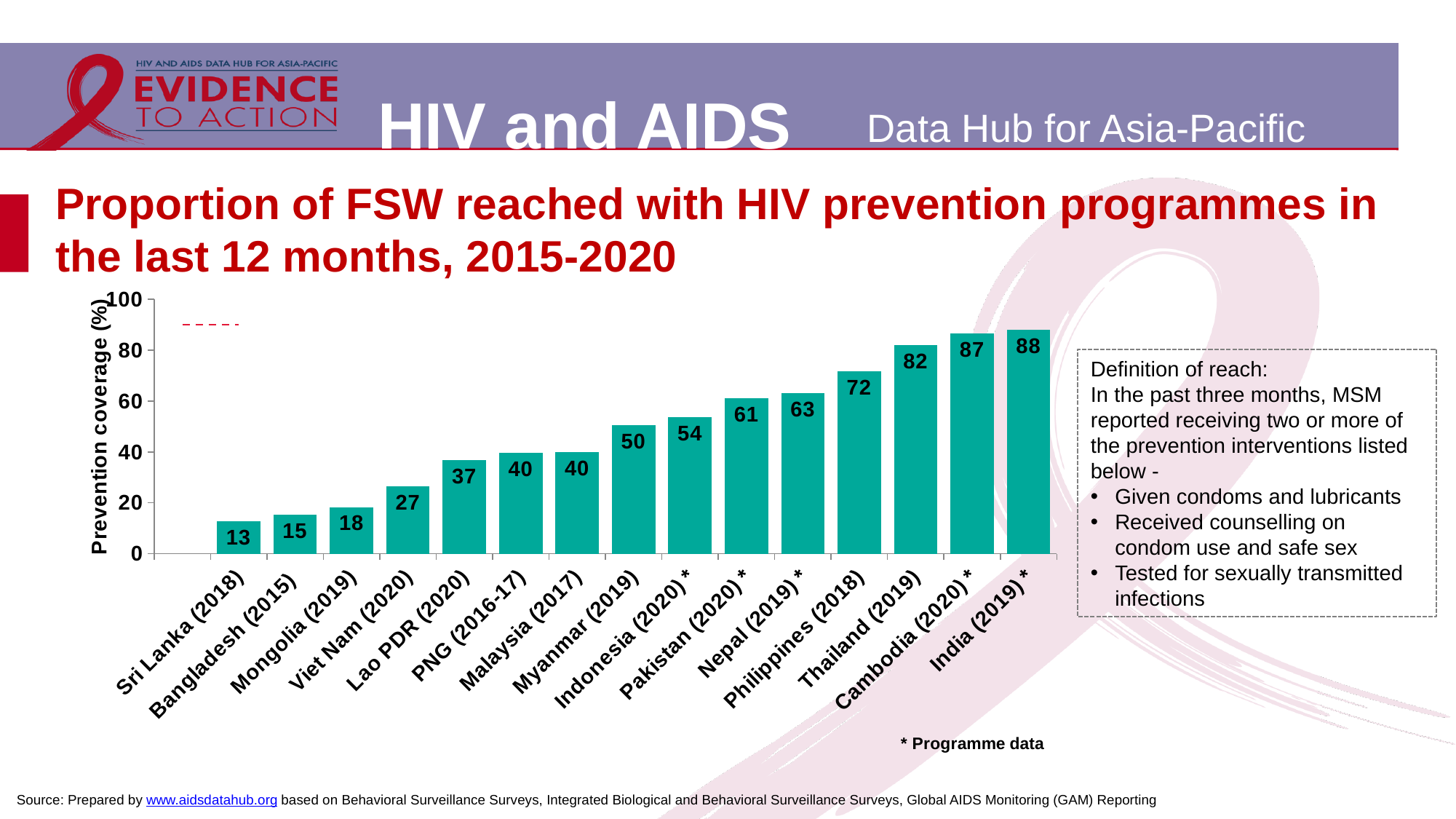
What is the label of the y axis? Prevention coverage (%) Is the value for Philippines (2018) greater or less than 60? greater Do the values rise or fall from left to right along the x axis? Rise Which country has the highest prevention coverage? India (2019)* What type of chart is shown on the slide? Bar chart What is the prevention coverage value for Viet Nam (2020)? 27 Which has a higher prevention coverage, Nepal (2019)* or Lao PDR (2020)? Nepal (2019)* Which country has the lowest prevention coverage? Sri Lanka (2018) How many countries are shown on the chart? 15 What is the difference in prevention coverage between Cambodia (2020)* and Mongolia (2019)? 69 What is the prevention coverage value for Pakistan (2020)*? 61 What is the prevention coverage value for Thailand (2019)? 82